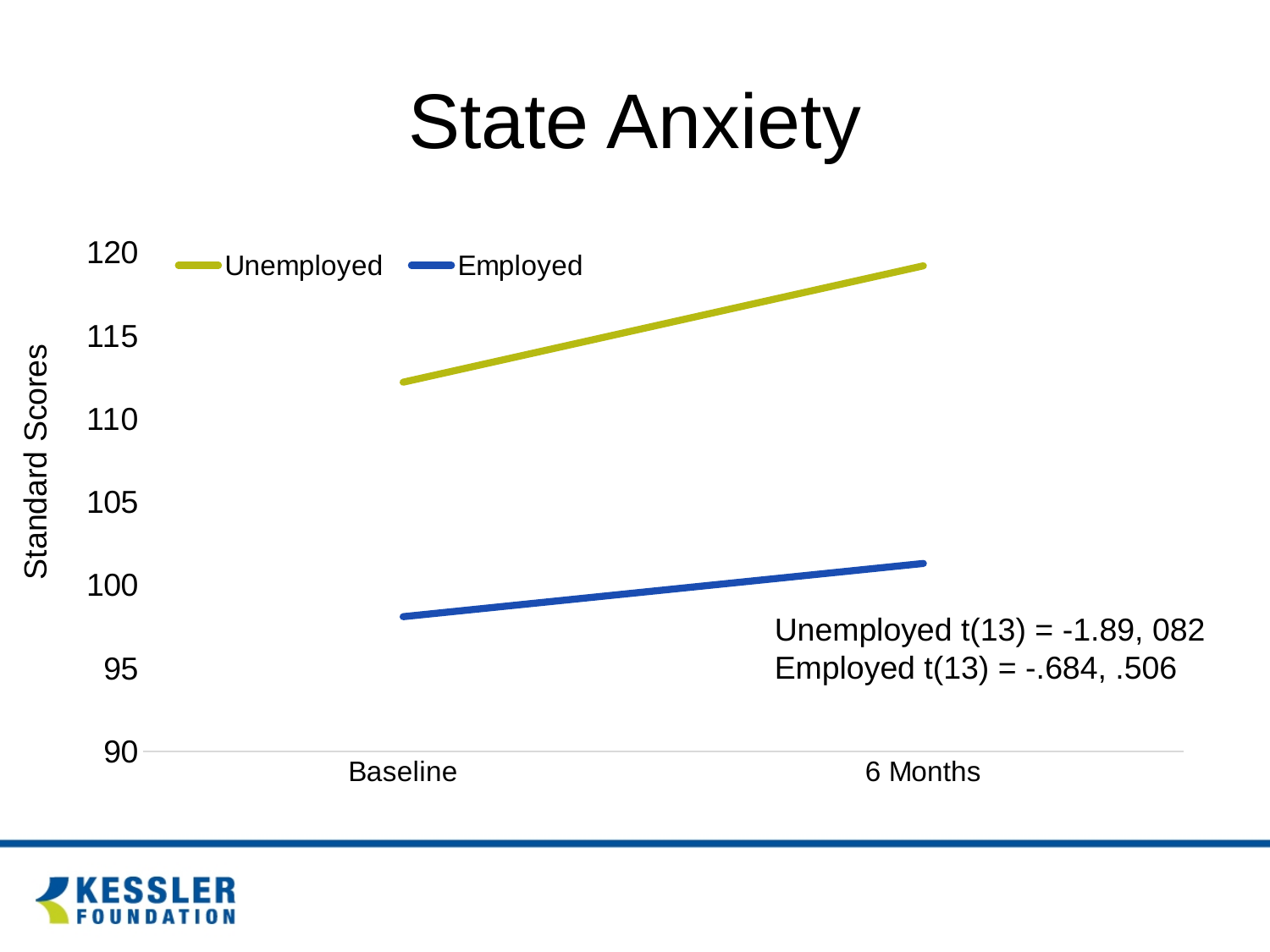
Is the value for Employed at Baseline greater or less than 100? less How many series does the legend list? 2 Is the value for Unemployed at 6 Months greater or less than 115? greater At 6 Months, which series has the lower value, Unemployed or Employed? Employed What is the title of the chart? State Anxiety How many time points are shown on the x axis? 2 At Baseline, which series has the higher value, Unemployed or Employed? Unemployed Is the value for Unemployed at Baseline greater or less than 110? greater What is the label on the y axis? Standard Scores Does the Unemployed line rise or fall from Baseline to 6 Months? Rises What kind of chart is shown on the slide? Line chart Does the Employed line rise or fall from Baseline to 6 Months? Rises